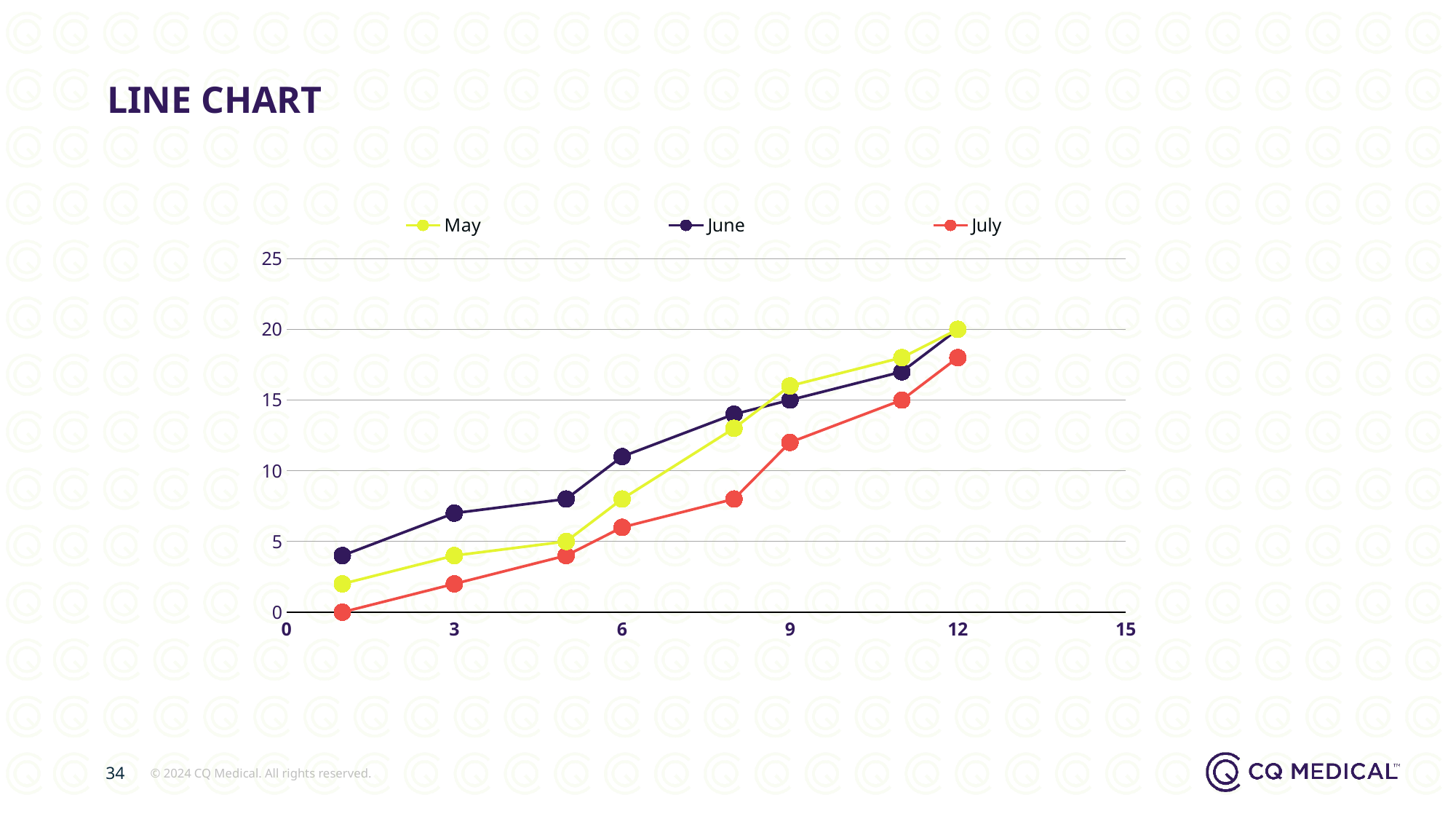
What is the value of the June series at x = 9? 15 Which series has the lowest value at x = 3? July At x = 9, which is larger, the June value or the July value? June Is the value for June at x = 6 greater or less than 10? greater What is the value of the May series at x = 12? 20 How many data points does the May series have? 8 What is the value of the July series at x = 11? 15 Do the values for the July series rise or fall as x increases? rise Which series are listed in the legend? May, June, July Is the value for July at x = 8 greater or less than 10? less How many series does the legend list? 3 What kind of chart is shown on the slide? line chart